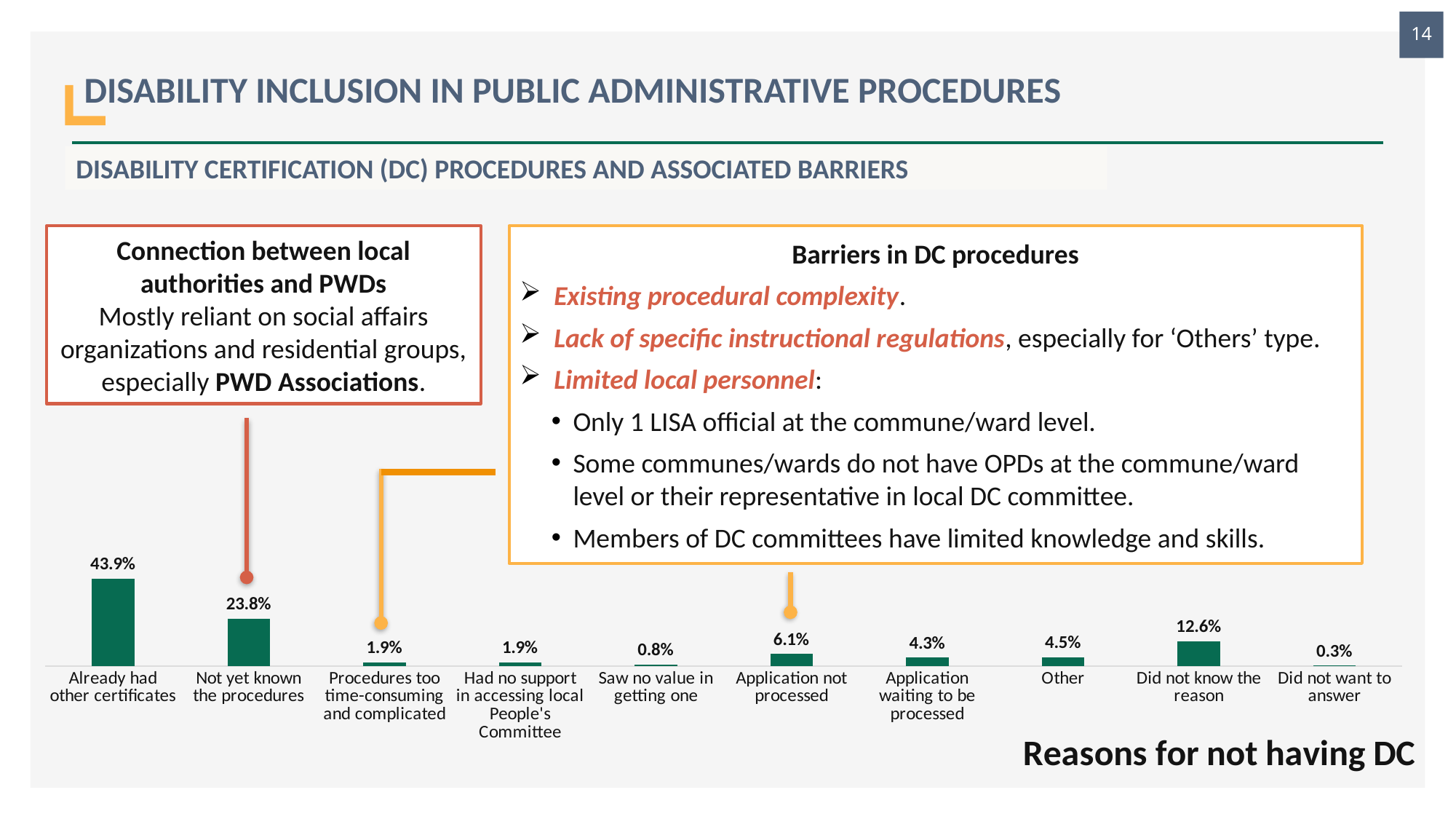
Which is larger: 'Application waiting to be processed' or 'Other'? Other Which category has the highest value in the chart? Already had other certificates What is the value for 'Not yet known the procedures'? 23.8% What is the value for 'Already had other certificates' in the Reasons for not having DC chart? 43.9% How many categories are shown in the chart? 10 What is the difference between 'Already had other certificates' and 'Not yet known the procedures'? 20.1% What is the title of the chart on the slide? Reasons for not having DC What is the value for 'Application not processed'? 6.1% What is the value for 'Saw no value in getting one'? 0.8% What kind of chart is shown on the slide? Bar chart Which category has the lowest value in the chart? Did not want to answer What is the value for 'Did not know the reason'? 12.6%